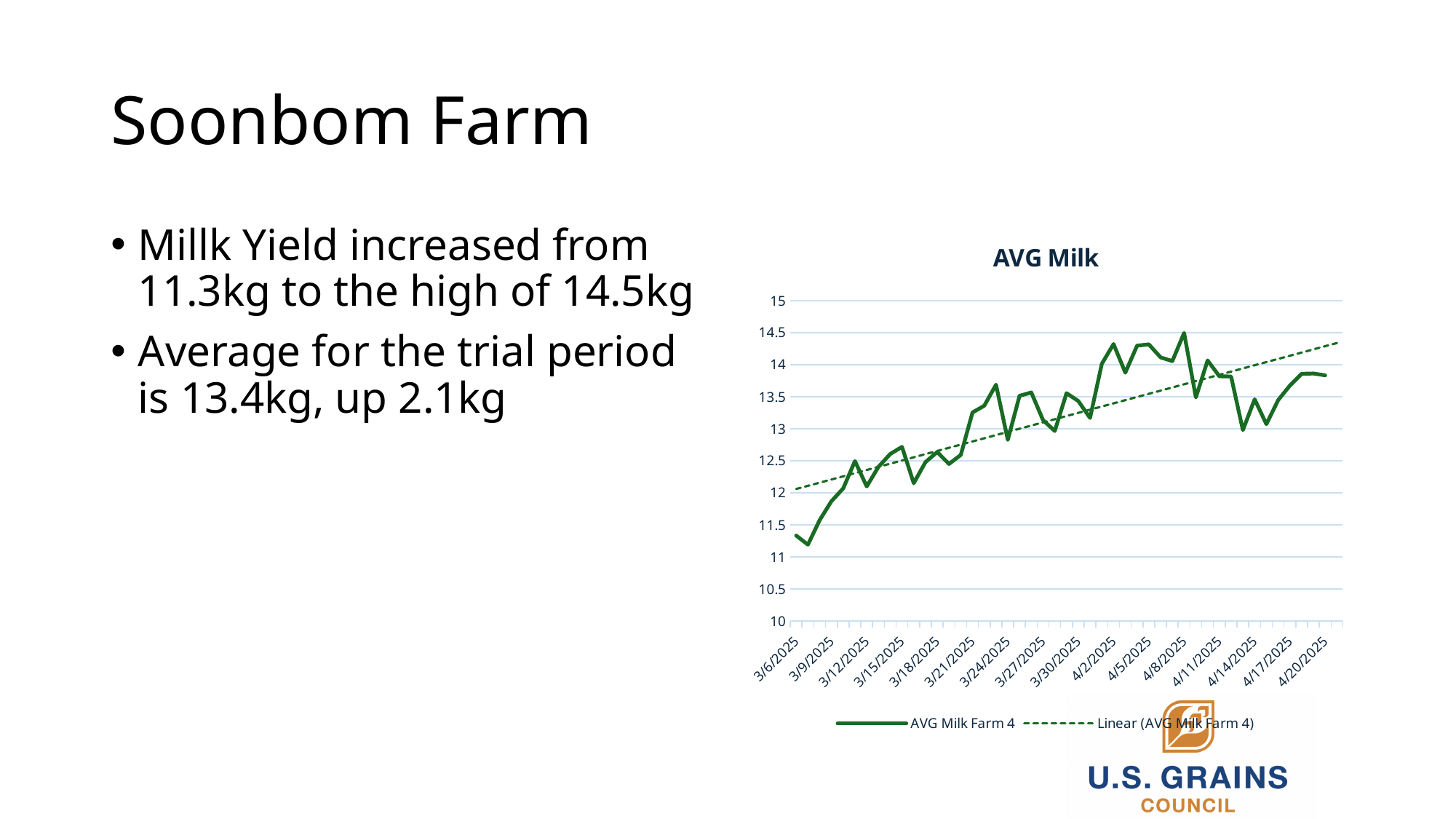
What is the title of the chart? AVG Milk How many entries does the chart legend list? 2 Is the value for AVG Milk Farm 4 on 3/15/2025 greater or less than 12? greater Is the value for AVG Milk Farm 4 on 3/6/2025 greater or less than 12? less What kind of chart is shown on the slide? line chart Is the value for AVG Milk Farm 4 on 4/20/2025 greater or less than 13.5? greater What is the name of the solid-line data series in the legend? AVG Milk Farm 4 On which labelled date does the AVG Milk Farm 4 line reach its highest point? 4/8/2025 How many date labels are shown on the x axis of the chart? 16 Which date has the larger AVG Milk Farm 4 value, 3/6/2025 or 4/2/2025? 4/2/2025 Does the AVG Milk Farm 4 line generally rise or fall from 3/6/2025 to 4/20/2025? rise